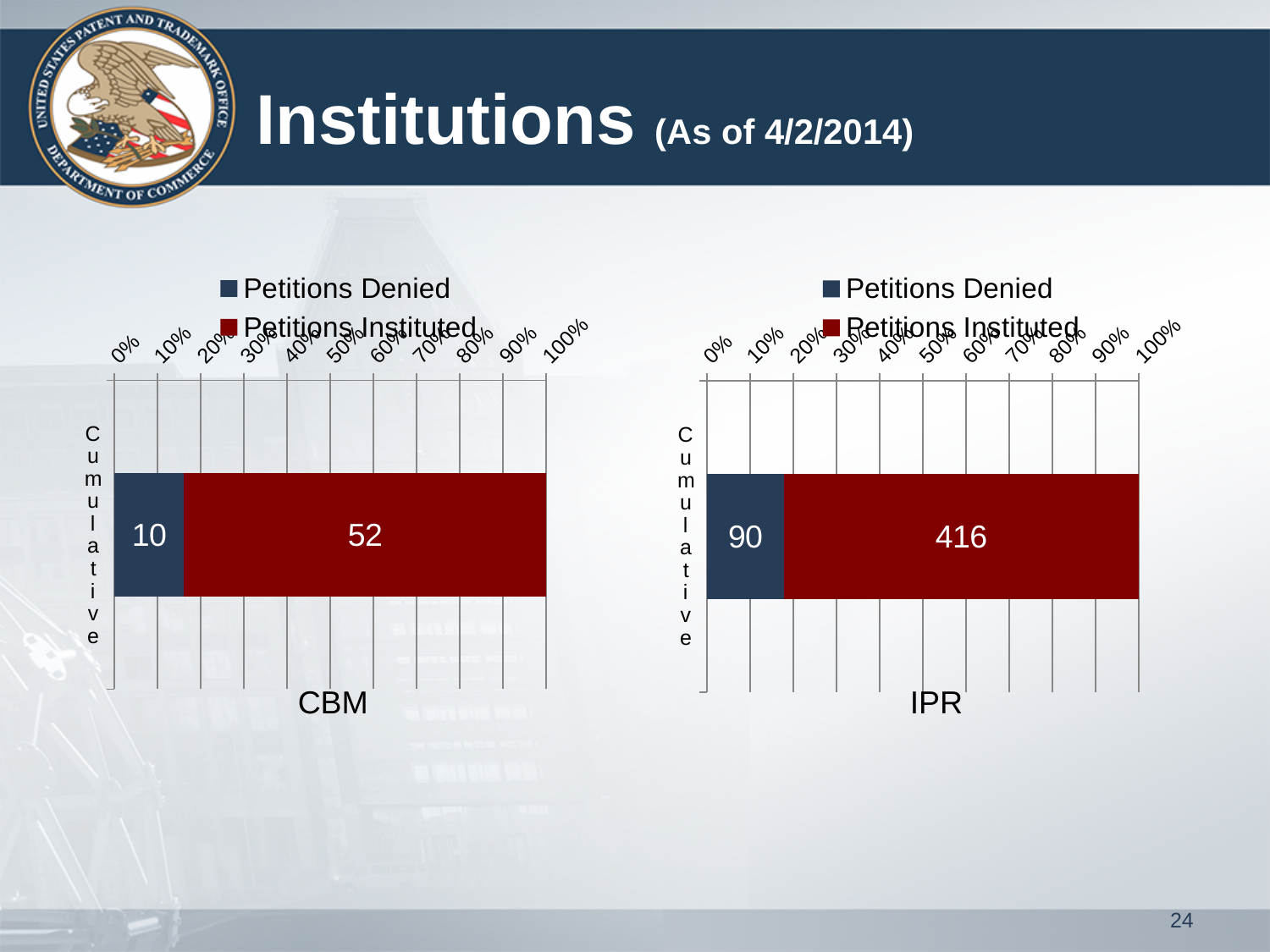
What kind of chart is the CBM chart on the left? Stacked bar chart In the IPR chart on the right, what is the total of the stacked bar (Petitions Denied plus Petitions Instituted)? 506 In the IPR chart on the right, what is the value for Petitions Denied? 90 In the IPR chart on the right, which is larger, Petitions Denied or Petitions Instituted? Petitions Instituted In the IPR chart on the right, what is the value for Petitions Instituted? 416 In the CBM chart on the left, is the Petitions Denied segment greater or less than 20% of the bar? less In the CBM chart on the left, what is the difference between Petitions Instituted and Petitions Denied? 42 In the CBM chart on the left, what is the total of the stacked bar (Petitions Denied plus Petitions Instituted)? 62 In the CBM chart on the left, what is the value for Petitions Instituted? 52 In the CBM chart on the left, what is the value for Petitions Denied? 10 How many series does the legend of the IPR chart on the right list? 2 In the IPR chart on the right, what is the difference between Petitions Instituted and Petitions Denied? 326